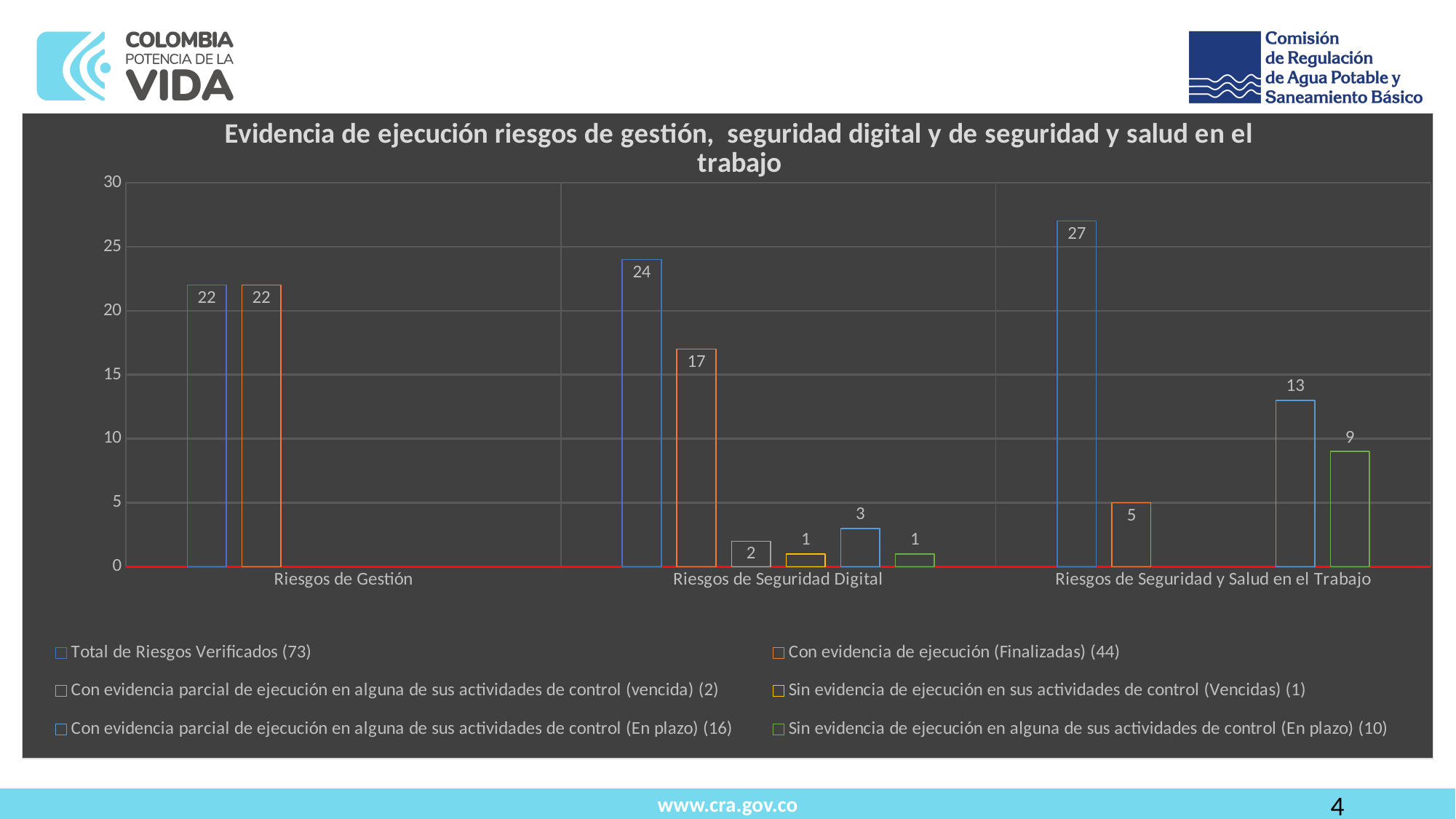
Which category has the lowest Con evidencia de ejecución (Finalizadas) value? Riesgos de Seguridad y Salud en el Trabajo How many series does the legend list? 6 What is the value of Total de Riesgos Verificados for Riesgos de Seguridad y Salud en el Trabajo? 27 What is the value of Con evidencia parcial de ejecución en alguna de sus actividades de control (En plazo) for Riesgos de Seguridad y Salud en el Trabajo? 13 Which category has the highest Total de Riesgos Verificados? Riesgos de Seguridad y Salud en el Trabajo What kind of chart is shown on the slide? Bar chart Is the Total de Riesgos Verificados for Riesgos de Seguridad Digital greater or less than 20? greater What is the value of Con evidencia de ejecución (Finalizadas) for Riesgos de Seguridad Digital? 17 What is the difference between Total de Riesgos Verificados and Con evidencia de ejecución (Finalizadas) for Riesgos de Seguridad y Salud en el Trabajo? 22 Which is larger for Riesgos de Seguridad Digital: Con evidencia parcial de ejecución (En plazo) or Con evidencia parcial de ejecución (vencida)? Con evidencia parcial de ejecución (En plazo) How many categories are shown on the x axis? 3 What is the value of Sin evidencia de ejecución en alguna de sus actividades de control (En plazo) for Riesgos de Seguridad Digital? 1